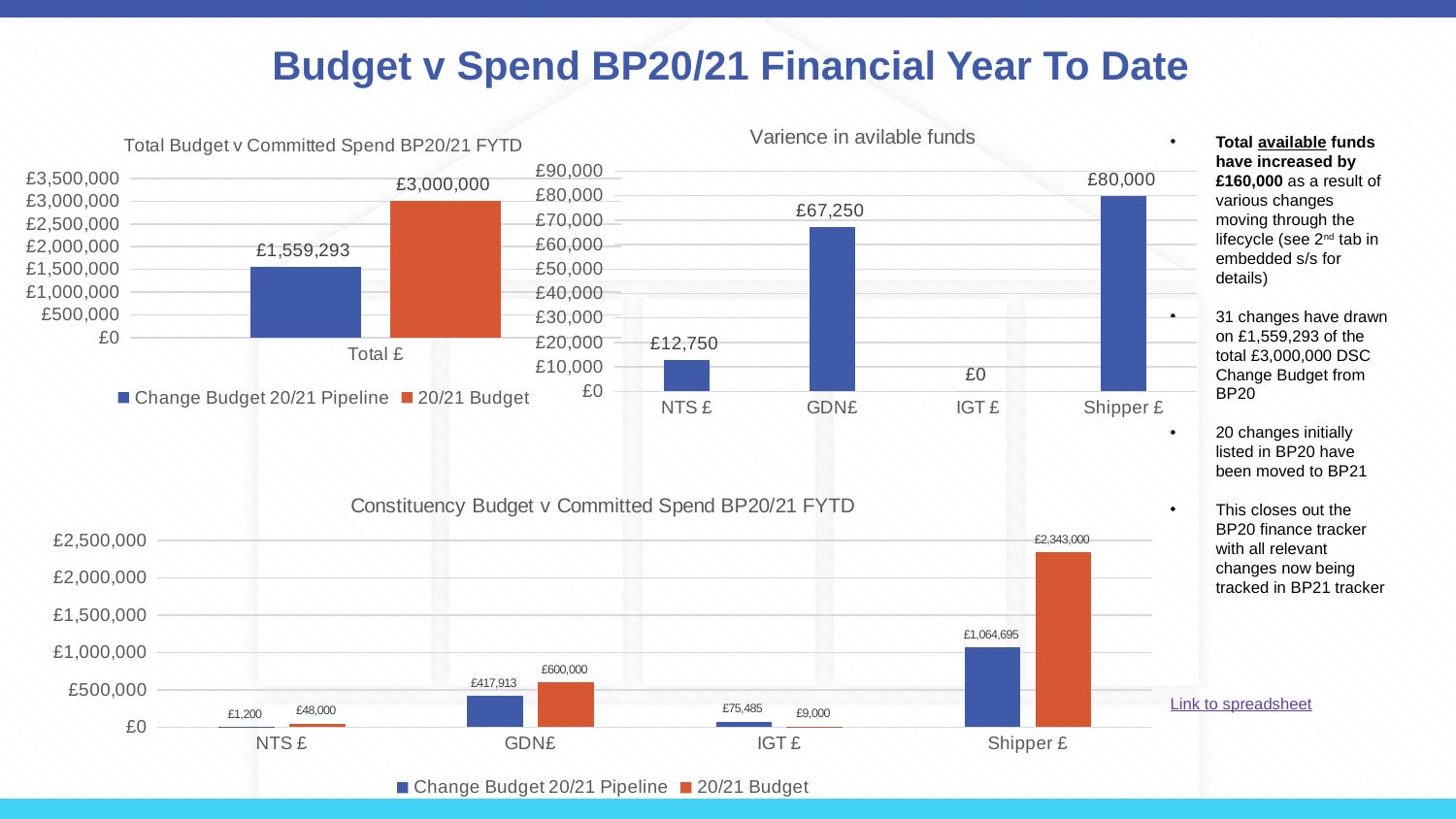
In the 'Varience in avilable funds' chart, how many categories are shown on the x axis? 4 In the 'Constituency Budget v Committed Spend BP20/21 FYTD' chart, how many series does the legend list? 2 In the 'Constituency Budget v Committed Spend BP20/21 FYTD' chart, which is larger for IGT £: the Change Budget 20/21 Pipeline or the 20/21 Budget? Change Budget 20/21 Pipeline In the 'Varience in avilable funds' chart, which category has the lowest value? IGT £ In the 'Constituency Budget v Committed Spend BP20/21 FYTD' chart, what is the 20/21 Budget value for Shipper £? £2,343,000 In the 'Varience in avilable funds' chart, what is the value for GDN£? £67,250 In the 'Total Budget v Committed Spend BP20/21 FYTD' chart, what is the value of the 20/21 Budget bar? £3,000,000 In the 'Varience in avilable funds' chart, which category has the highest value? Shipper £ In the 'Varience in avilable funds' chart, what is the difference between Shipper £ and NTS £? £67,250 In the 'Constituency Budget v Committed Spend BP20/21 FYTD' chart, what is the Change Budget 20/21 Pipeline value for GDN£? £417,913 In the 'Total Budget v Committed Spend BP20/21 FYTD' chart, what is the value of the Change Budget 20/21 Pipeline bar? £1,559,293 In the 'Total Budget v Committed Spend BP20/21 FYTD' chart, what is the difference between the 20/21 Budget and the Change Budget 20/21 Pipeline? £1,440,707